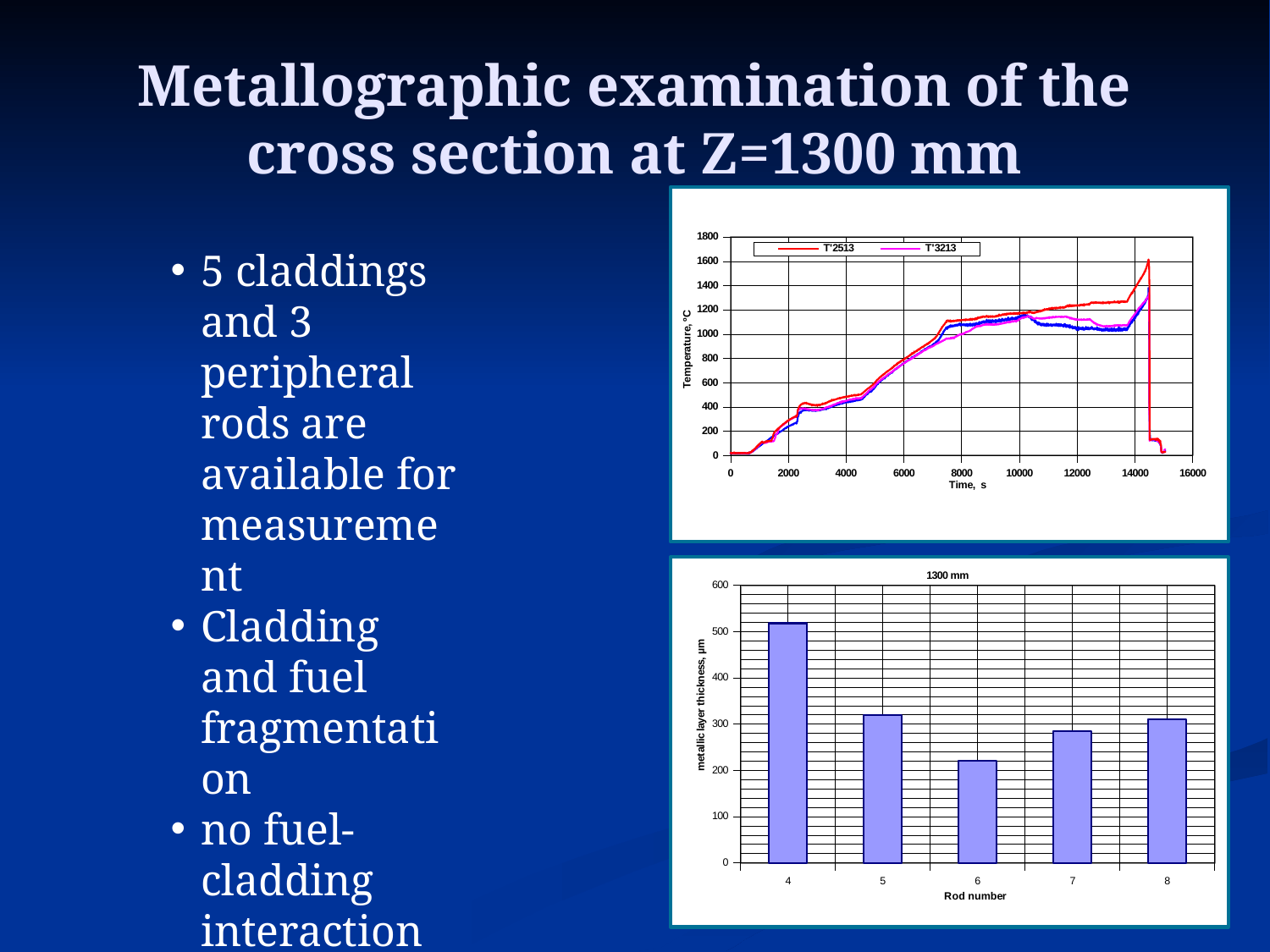
In the bottom chart titled '1300 mm', is the value for rod 8 greater or less than 200? greater What is the y-axis label of the top line chart? Temperature, °C In the top chart, do the temperatures generally rise or fall between 0 and 14000 s? rise In the bottom chart titled '1300 mm', which rod number has the lowest metallic layer thickness? 6 What is the title of the bottom bar chart? 1300 mm In the bottom chart titled '1300 mm', which rod number has the highest metallic layer thickness? 4 How many rod numbers are shown on the x axis of the bottom chart titled '1300 mm'? 5 In the bottom chart titled '1300 mm', is the value for rod 6 greater or less than 300? less What kind of chart is the bottom chart titled '1300 mm'? bar chart In the bottom chart titled '1300 mm', is the value for rod 4 greater or less than 500? greater How many series does the legend of the top temperature chart list? 2 In the bottom chart titled '1300 mm', which has the larger metallic layer thickness, rod 5 or rod 7? rod 5